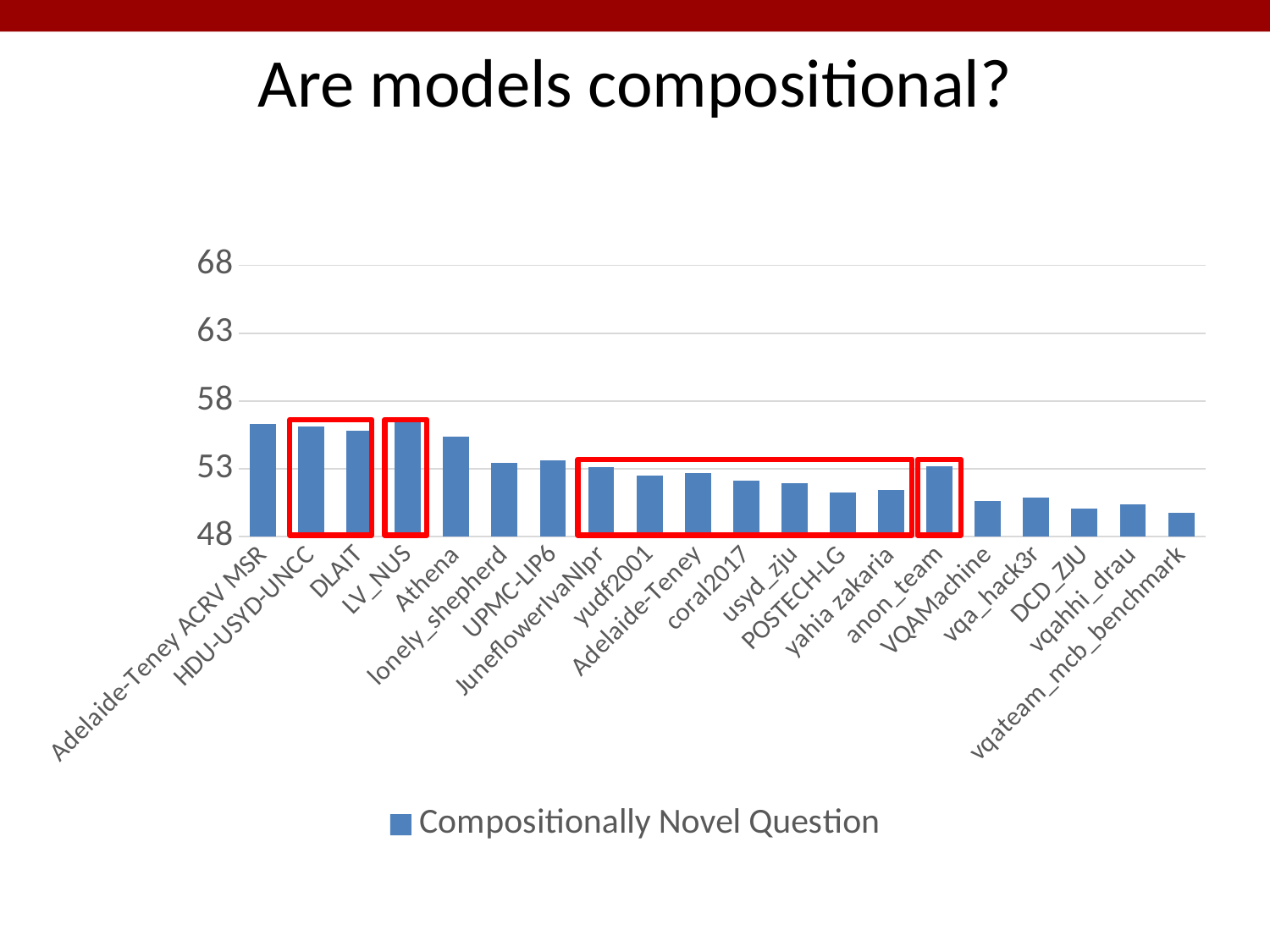
Which has the larger value, Athena or VQAMachine? Athena What is the title of the slide containing the chart? Are models compositional? What is the name of the series shown in the legend? Compositionally Novel Question Is the value for Athena greater or less than 53? greater Is the value for vqateam_mcb_benchmark greater or less than 48? greater Is the value for VQAMachine greater or less than 53? less How many series does the legend list? 1 What kind of chart is shown on the slide? bar chart How many categories (teams) are plotted on the x axis? 20 Which has the larger value, DLAIT or DCD_ZJU? DLAIT Do the values generally rise or fall moving from left to right along the x axis? fall